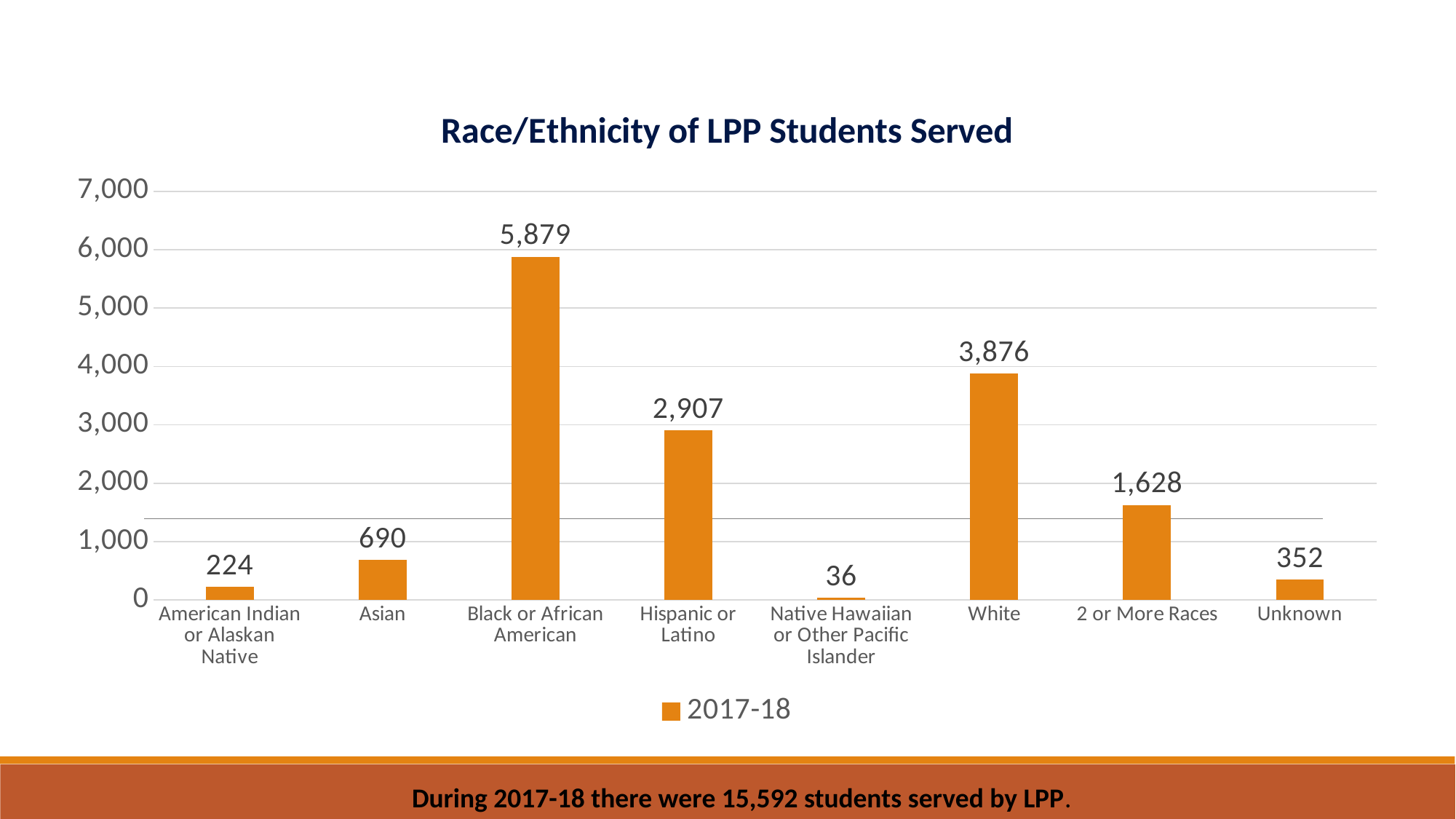
What is the value for Black or African American? 5,879 What is the value for Native Hawaiian or Other Pacific Islander? 36 How many categories are shown on the x axis? 8 Which category has the highest value? Black or African American Which is larger, the value for Asian or the value for Unknown? Asian What is the value for White? 3,876 What is the difference between the values for Black or African American and White? 2,003 Is the value for Hispanic or Latino greater or less than 3,000? less What is the title of the chart? Race/Ethnicity of LPP Students Served Which category has the lowest value? Native Hawaiian or Other Pacific Islander What is the value for 2 or More Races? 1,628 What kind of chart is shown on the slide? bar chart